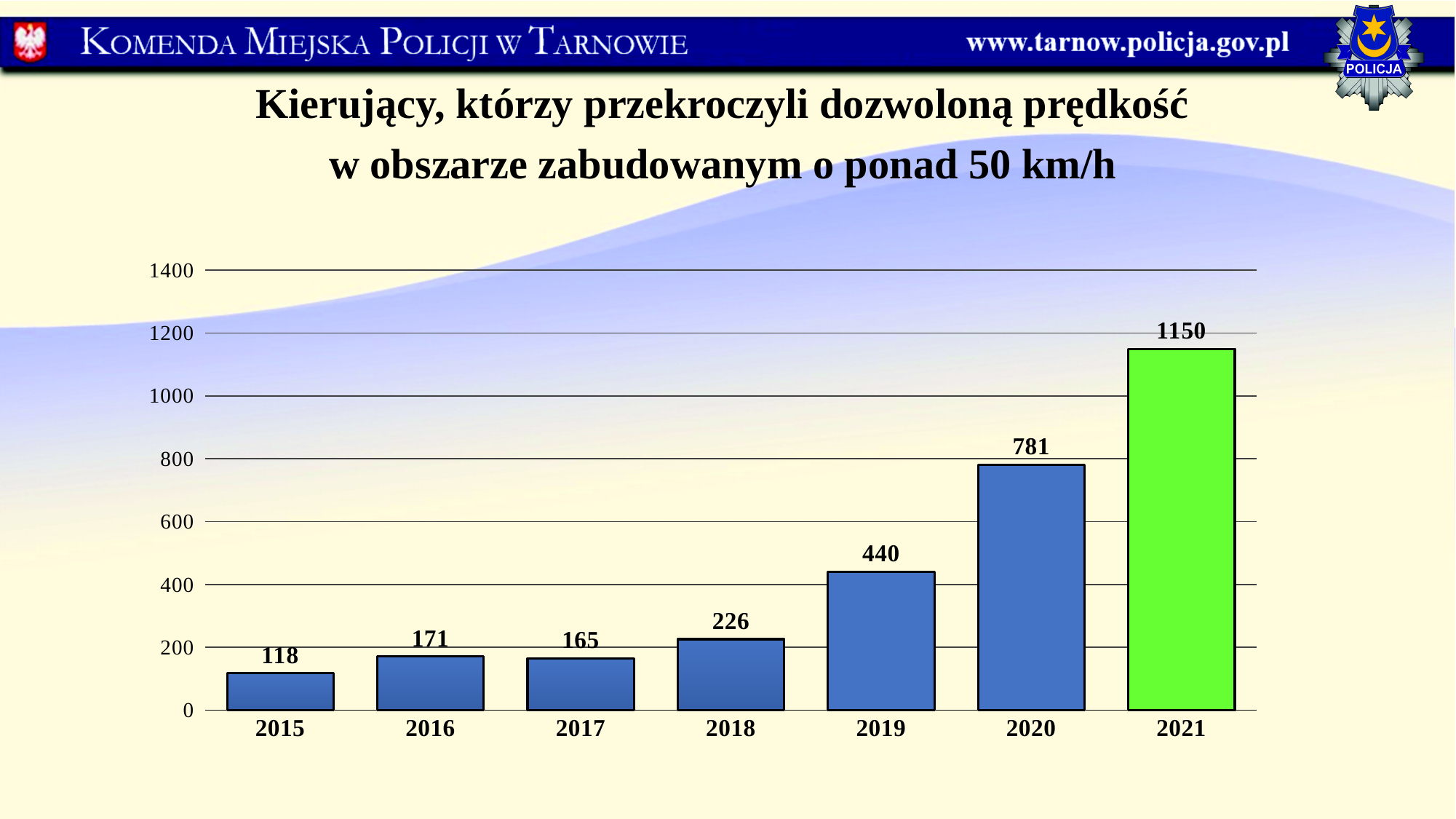
What is the value for 2019? 440 Which is larger, the value for 2018 or the value for 2017? 2018 What is the value for 2021? 1150 Is the value for 2020 greater or less than 600? greater Which year has the lowest value? 2015 What colour is the bar for 2021? green What kind of chart is shown on the slide? bar chart What is the value for 2015? 118 What is the difference between the values for 2021 and 2020? 369 Which year has the highest value? 2021 How many years are shown on the x axis? 7 What is the difference between the values for 2016 and 2017? 6